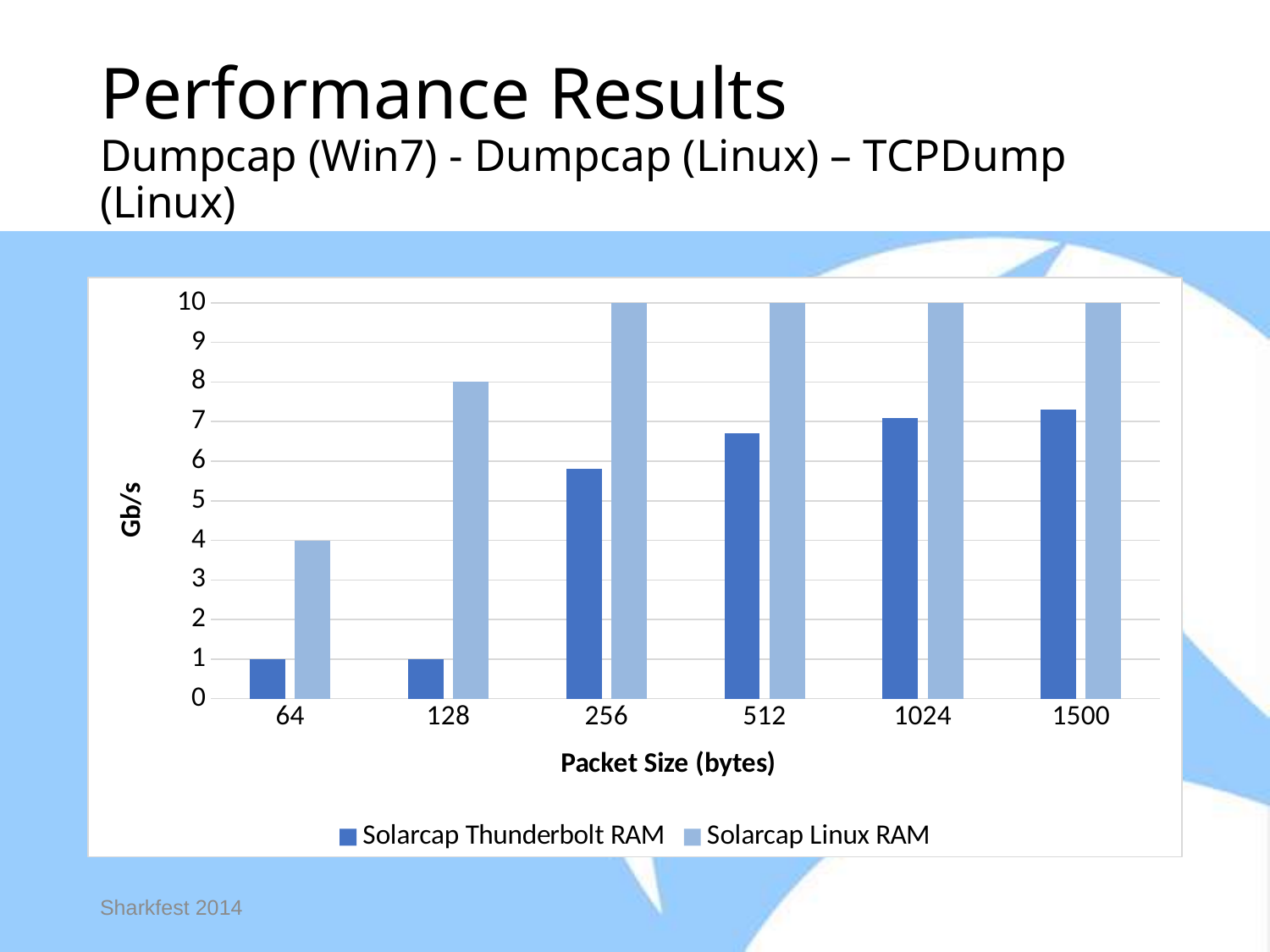
How many packet size categories are shown on the x axis? 6 At which packet size is Solarcap Linux RAM lowest? 64 Is the value for Solarcap Thunderbolt RAM at packet size 256 greater or less than 5? greater What is the label of the y axis? Gb/s What is the value for Solarcap Linux RAM at packet size 128? 8 How many series does the legend list? 2 Is the value for Solarcap Thunderbolt RAM at packet size 512 greater or less than 7? less What is the value for Solarcap Linux RAM at packet size 256? 10 What is the difference between Solarcap Linux RAM at 128 and at 64? 4 What type of chart is shown on the slide? bar chart What is the value for Solarcap Thunderbolt RAM at packet size 64? 1 What is the value for Solarcap Linux RAM at packet size 64? 4